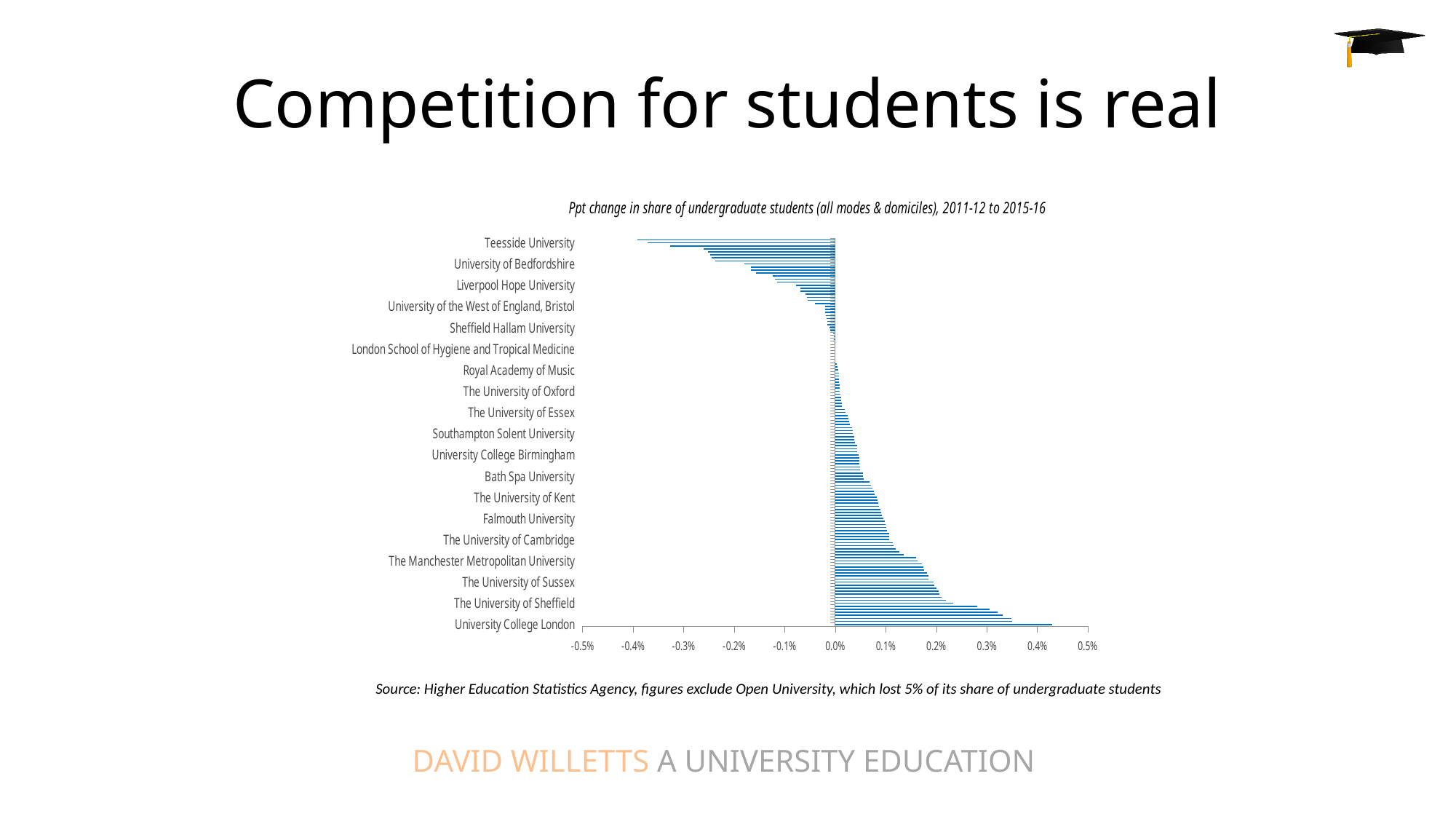
Do the values rise or fall moving from the top of the chart to the bottom? rise Is the value for The University of Sussex greater or less than 0.0%? greater Which labelled university has the highest (most positive) change in share? University College London Is the value for University College London greater or less than 0.3%? greater Which labelled university has the lowest (most negative) change in share? Teesside University Which has the larger value, University College London or Teesside University? University College London What is the range of the horizontal axis? -0.5% to 0.5% What kind of chart is shown on the slide? bar chart Is the value for Teesside University greater or less than -0.3%? less Which has the larger value, Bath Spa University or University of Bedfordshire? Bath Spa University What is the title of the chart? Ppt change in share of undergraduate students (all modes & domiciles), 2011-12 to 2015-16